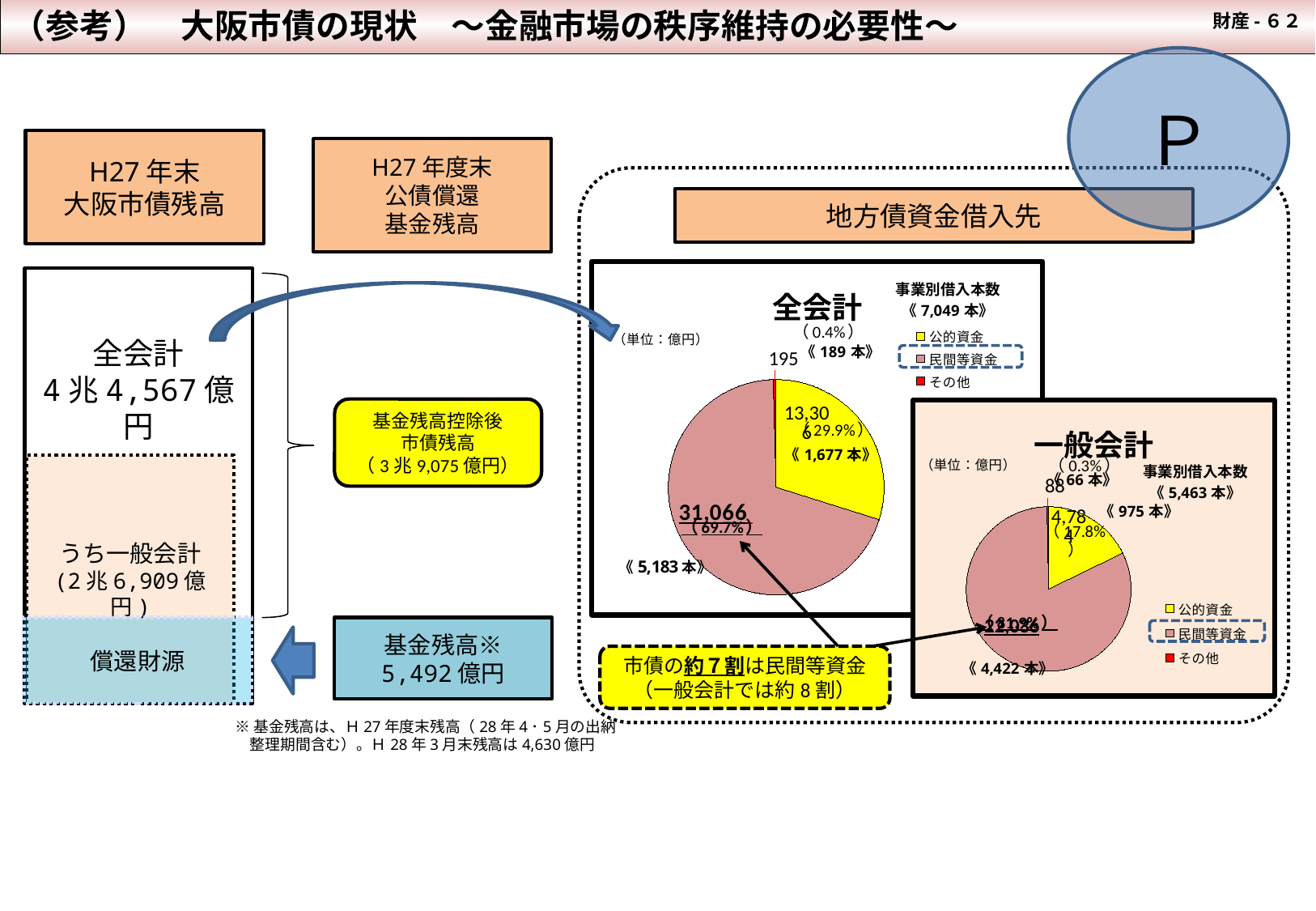
In the 一般会計 pie chart, what share of the pie is 公的資金? 17.8% What kind of chart is the 全会計 chart on the slide? pie chart In the 全会計 pie chart, what share of the pie is 公的資金? 29.9% In the 全会計 pie chart, what is the value for 民間等資金? 31,066 In the 全会計 pie chart, which category has the smallest slice? その他 In the 全会計 pie chart, what is the difference between the 民間等資金 value and the その他 value? 30,871 How many entries does the legend of the 全会計 pie chart list? 3 In the 一般会計 pie chart, which category has the largest slice? 民間等資金 In the 全会計 pie chart, what share of the pie is 民間等資金? 69.7% In the 全会計 pie chart, what is the value for その他? 195 In the 全会計 pie chart, which category has the largest slice? 民間等資金 What unit is stated for the values in the 全会計 pie chart? 億円